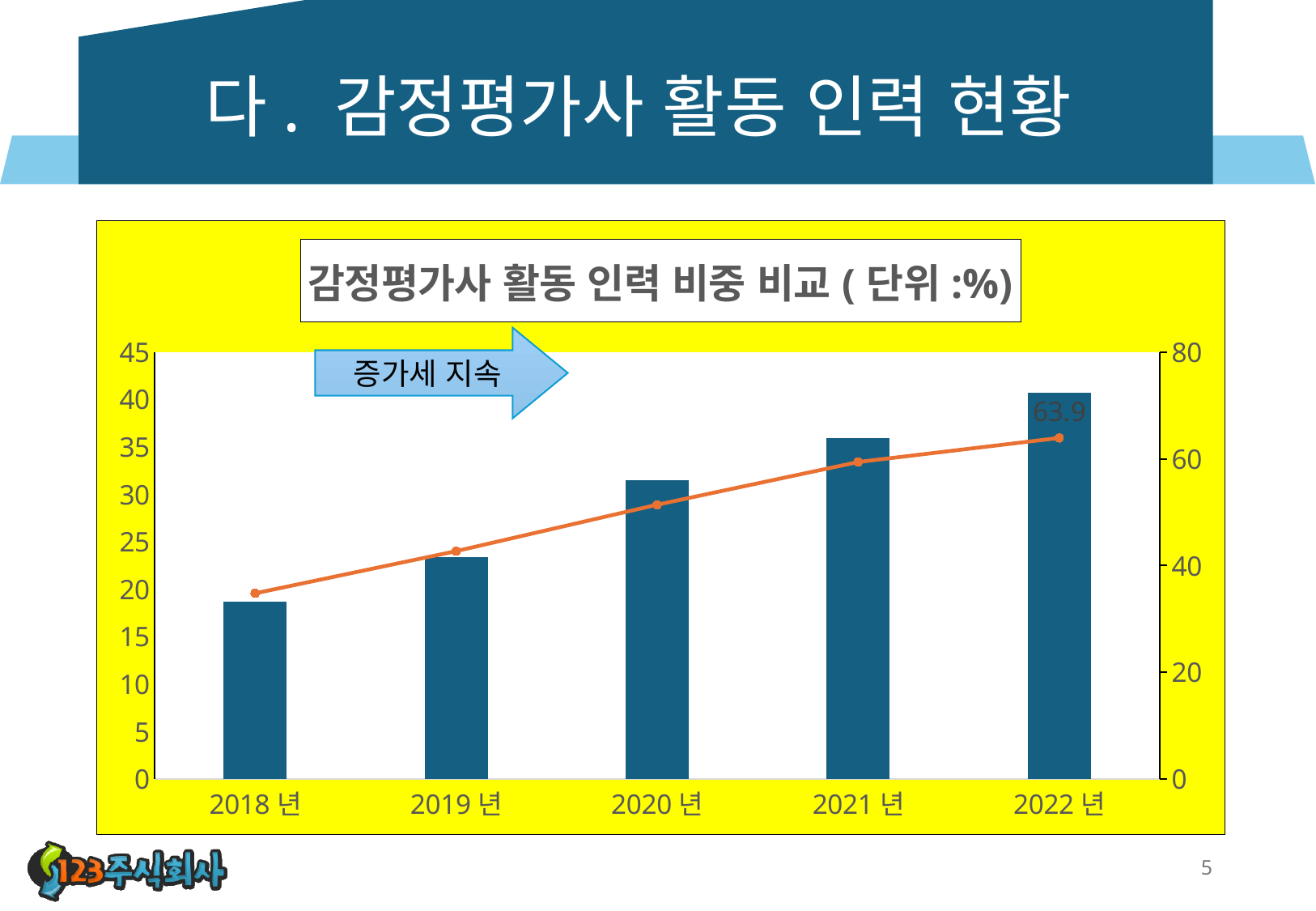
Is the bar value for 2018 년 greater or less than 20 on the left axis? less What kind of chart is this? A bar chart combined with a line chart Is the bar value for 2020 년 greater or less than 30 on the left axis? greater Is the line value for 2018 년 greater or less than 40 on the right axis? less What text is written inside the blue arrow on the chart? 증가세 지속 Which bar is taller, 2019 년 or 2021 년? 2021 년 Do the bar values rise or fall from 2018 년 to 2022 년? rise What is the data label shown on the line for 2022 년? 63.9 Which year has the tallest bar? 2022 년 How many years are shown on the x axis? 5 Which year has the shortest bar? 2018 년 What is the title of the chart? 감정평가사 활동 인력 비중 비교 ( 단위 :%)